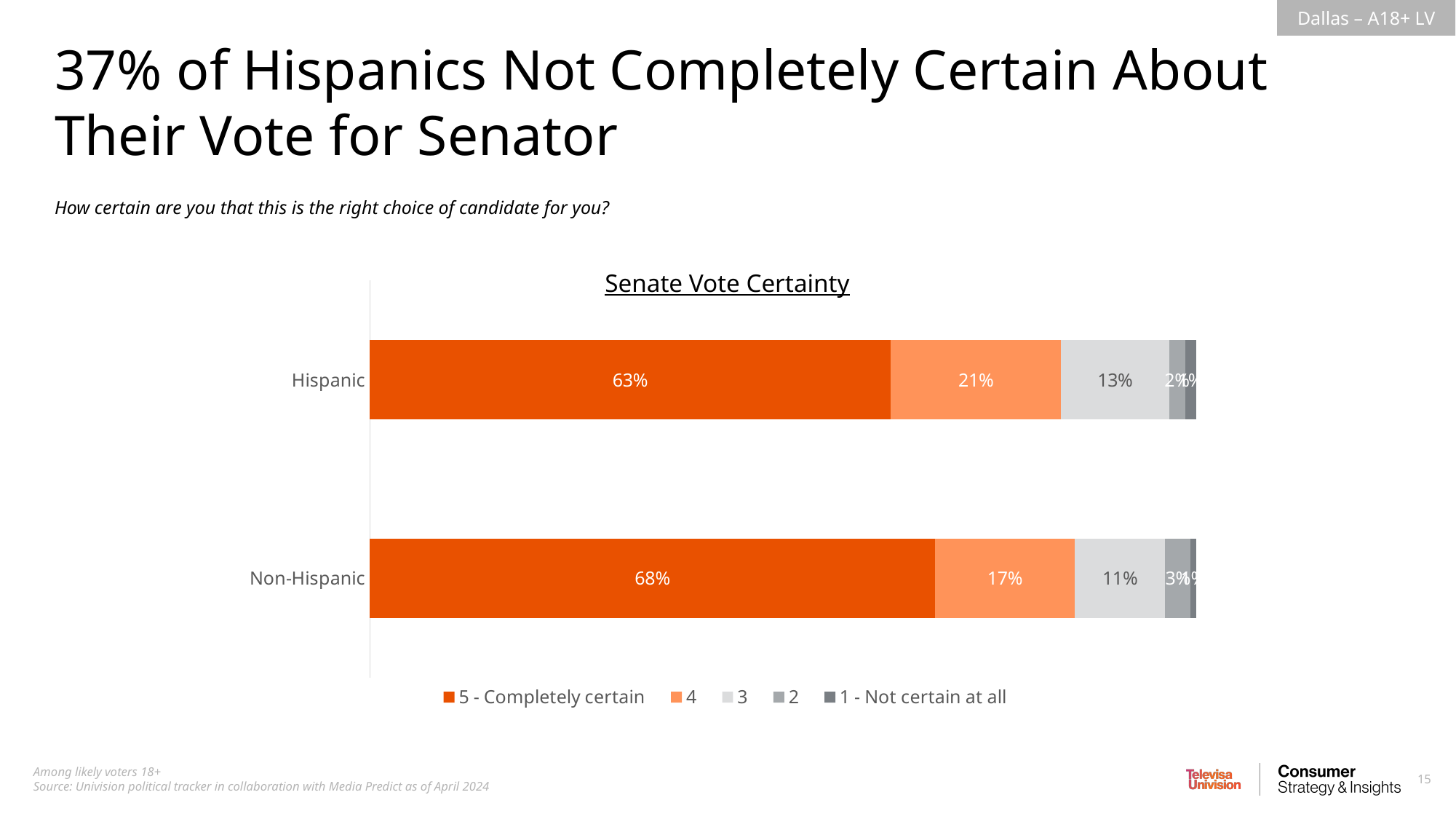
What is the difference between the '5 - Completely certain' values for Non-Hispanic and Hispanic respondents? 5% What is the title of the chart? Senate Vote Certainty What is the value of the '3' segment for Non-Hispanic respondents? 11% Which group has the higher share of '5 - Completely certain' respondents, Hispanic or Non-Hispanic? Non-Hispanic What is the value of the '4' segment for Hispanic respondents? 21% What percentage of Non-Hispanic respondents are '5 - Completely certain'? 68% What is the difference between the '4' values for Hispanic and Non-Hispanic respondents? 4% How many series does the legend list? 5 What is the value of the '2' segment for Hispanic respondents? 2% What kind of chart is shown on the slide? Stacked bar chart What percentage of Hispanic respondents are '5 - Completely certain'? 63% How many categories are shown on the chart? 2